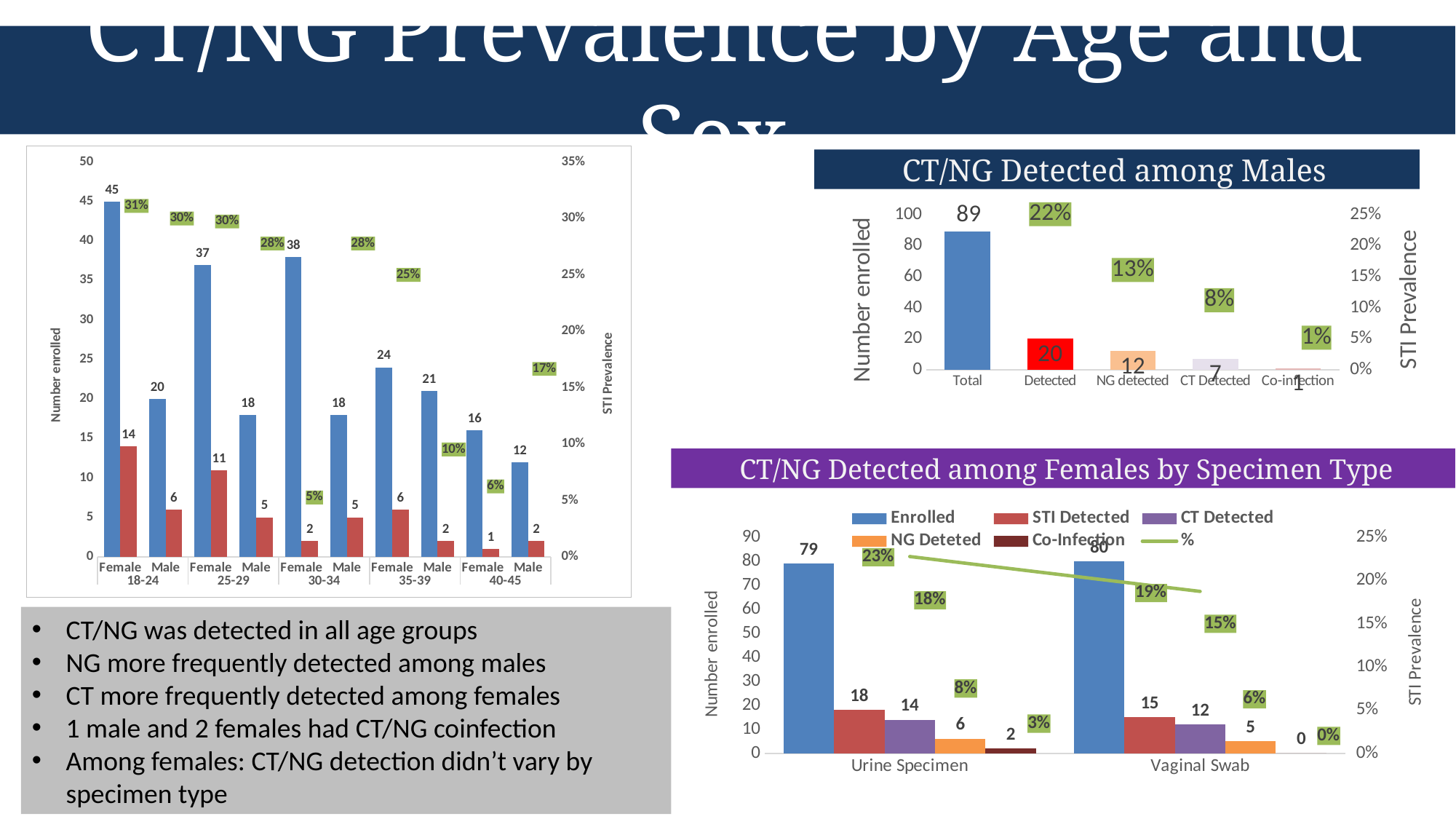
In the 'CT/NG Detected among Males' chart, what is the value for Total? 89 In the 'CT/NG Detected among Females by Specimen Type' chart, what is the Enrolled value for Vaginal Swab? 80 In the chart on the left of the slide, what is the STI prevalence for Female 30-34? 5% In the 'CT/NG Detected among Females by Specimen Type' chart, how many series does the legend list? 6 In the 'CT/NG Detected among Males' chart, which category has the lowest value? Co-infection In the chart on the left of the slide, which group has the highest number enrolled? Female 18-24 In the 'CT/NG Detected among Males' chart, what is the difference between Detected and CT Detected? 13 In the 'CT/NG Detected among Females by Specimen Type' chart, what is the STI Detected value for Urine Specimen? 18 In the chart on the left of the slide, what is the number enrolled for Female 18-24? 45 In the 'CT/NG Detected among Males' chart, what is the value for NG detected? 12 In the chart on the left of the slide, what is the difference in number enrolled between Female 25-29 and Male 25-29? 19 In the 'CT/NG Detected among Females by Specimen Type' chart, which is larger: CT Detected for Urine Specimen or CT Detected for Vaginal Swab? Urine Specimen